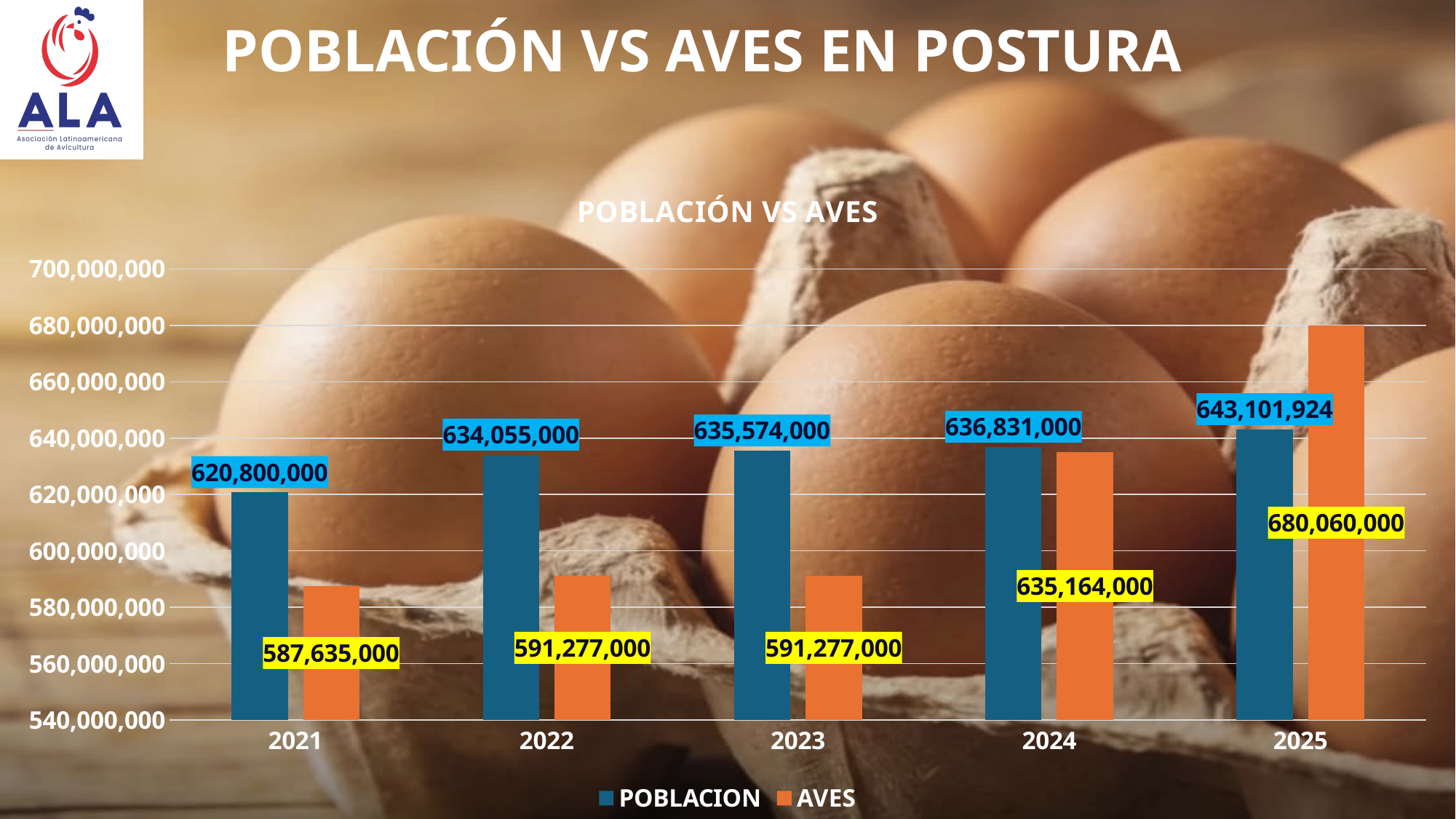
Is the AVES value for 2021 greater or less than 600,000,000? less What is the AVES value for 2024? 635,164,000 What is the difference between the AVES and POBLACION values in 2025? 36,958,076 In which year is the AVES value lowest? 2021 In 2022, which is larger, POBLACION or AVES? POBLACION How many series does the legend list? 2 What is the AVES value for 2025? 680,060,000 How many years are shown on the x axis? 5 In which year is the POBLACION value highest? 2025 What is the POBLACION value for 2023? 635,574,000 What is the POBLACION value for 2021? 620,800,000 What is the difference between the POBLACION and AVES values in 2021? 33,165,000